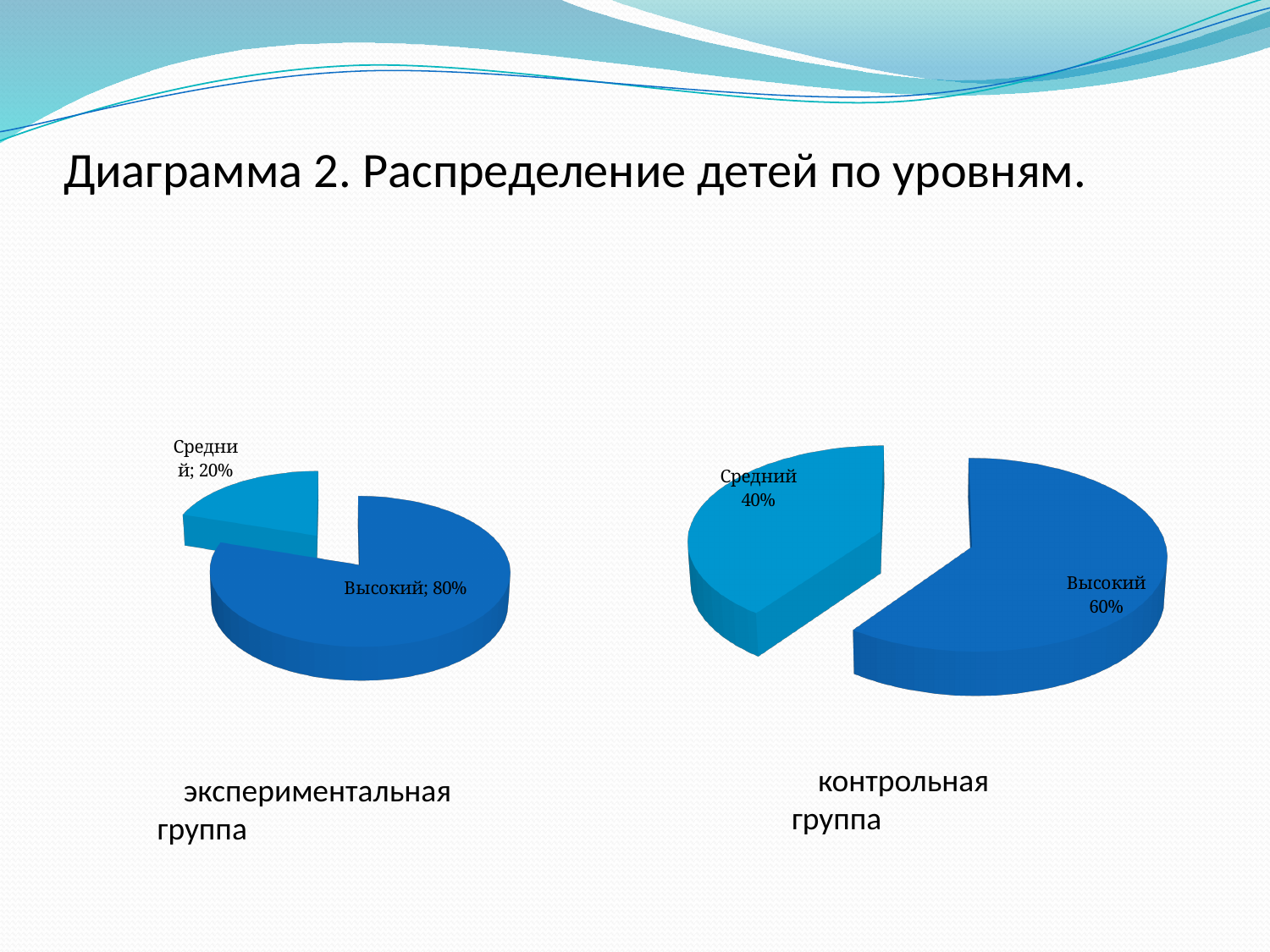
In the left pie chart (экспериментальная группа), which category has the largest share? Высокий In the left pie chart (экспериментальная группа), what is the value for Средний? 20% How many slices does the left pie chart (экспериментальная группа) have? 2 In the left pie chart (экспериментальная группа), what is the difference between Высокий and Средний? 60% In the left pie chart (экспериментальная группа), what is the value for Высокий? 80% What is the title of the slide? Диаграмма 2. Распределение детей по уровням. In the right pie chart (контрольная группа), what is the value for Средний? 40% Which chart has the larger value for Высокий, the left (экспериментальная группа) or the right (контрольная группа)? left (экспериментальная группа) What type of chart is shown on the right (контрольная группа)? pie chart In the right pie chart (контрольная группа), what is the difference between Высокий and Средний? 20% In the right pie chart (контрольная группа), what is the value for Высокий? 60% In the right pie chart (контрольная группа), which category has the smallest share? Средний